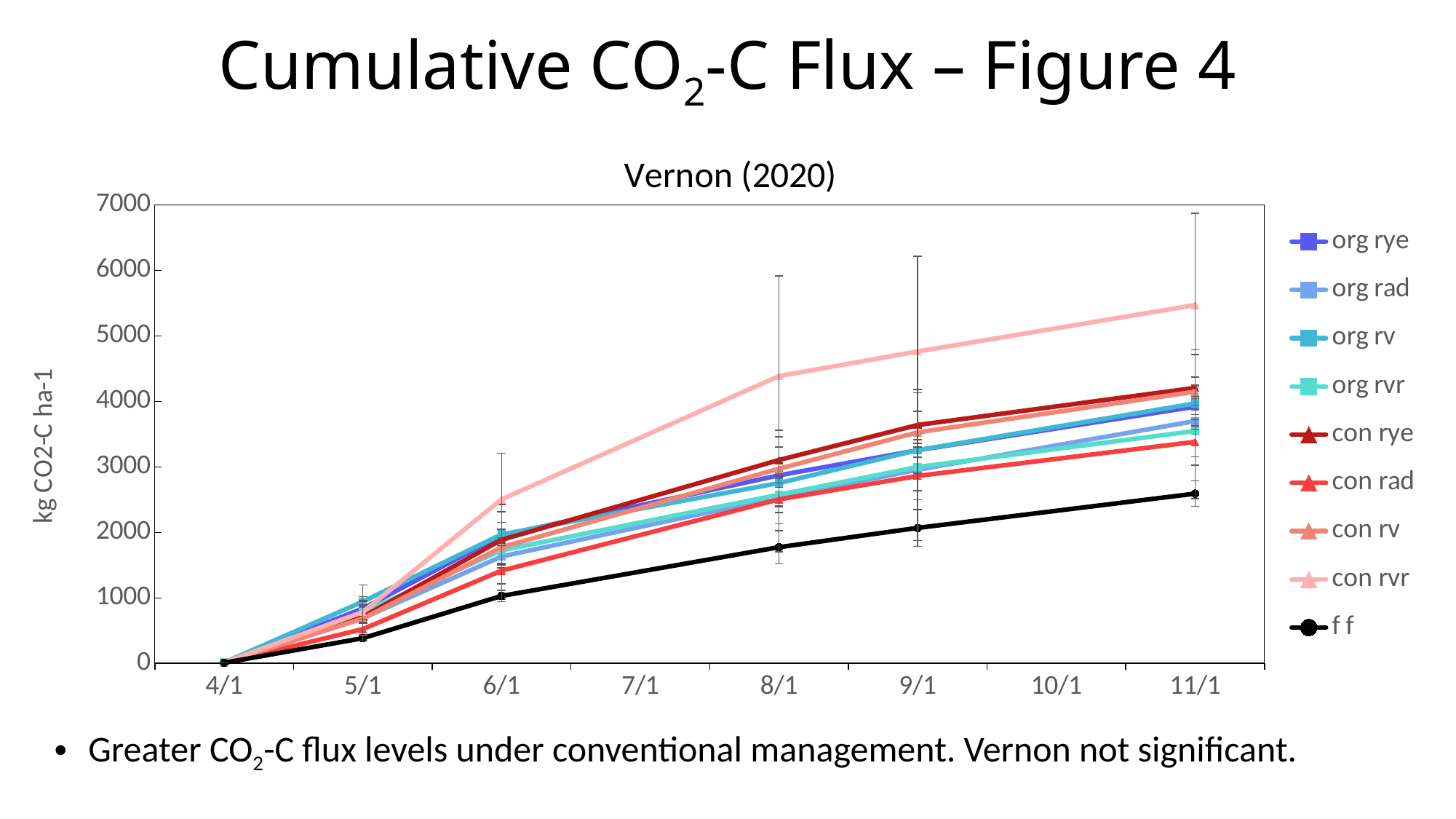
Is the value for con rvr at 8/1 greater or less than 4000? greater What is the label on the vertical axis? kg CO2-C ha-1 At 8/1, which is larger, con rvr or con rad? con rvr What kind of chart is shown on the slide? line chart Is the value for con rvr at 11/1 greater or less than 5000? greater Which series has the lowest value at 11/1? f f How many series does the legend list? 9 Is the value for con rad at 11/1 greater or less than 4000? less Do the values for f f rise or fall from 4/1 to 11/1? rise What is the title of the chart? Vernon (2020) Which series has the highest value at 11/1? con rvr